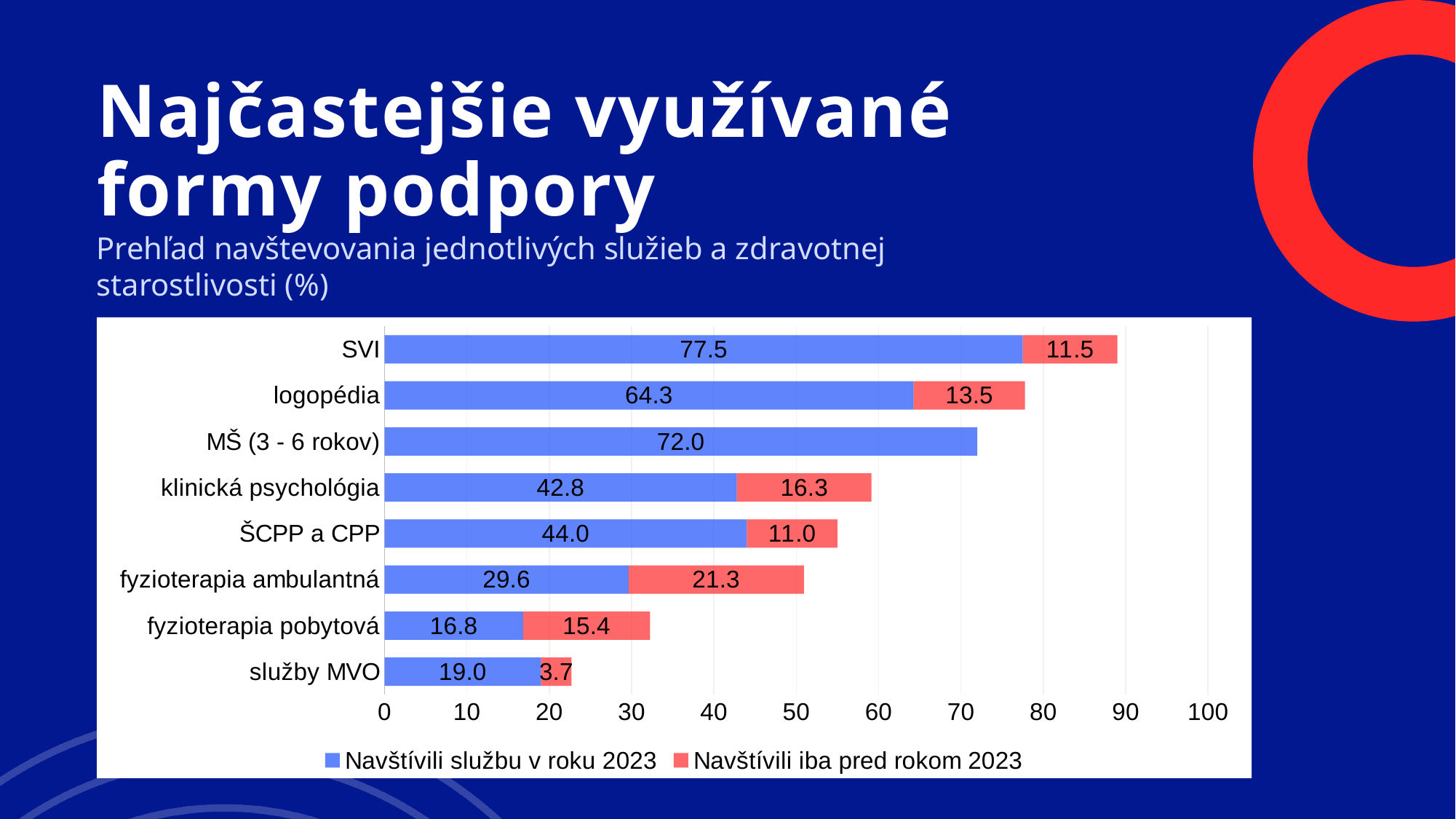
Which is larger: the 'Navštívili službu v roku 2023' value for klinická psychológia or for ŠCPP a CPP? ŠCPP a CPP Which category has the highest value for 'Navštívili službu v roku 2023'? SVI How many series does the legend list? 2 Which series is shown in red? Navštívili iba pred rokom 2023 What is the total of the stacked bar for logopédia? 77.8 How many categories are shown on the chart? 8 What is the value of 'Navštívili iba pred rokom 2023' for fyzioterapia ambulantná? 21.3 What is the value of 'Navštívili službu v roku 2023' for SVI? 77.5 What is the value of 'Navštívili službu v roku 2023' for MŠ (3 - 6 rokov)? 72.0 What is the difference between the 'Navštívili službu v roku 2023' values for SVI and logopédia? 13.2 What kind of chart is shown on the slide? stacked bar chart